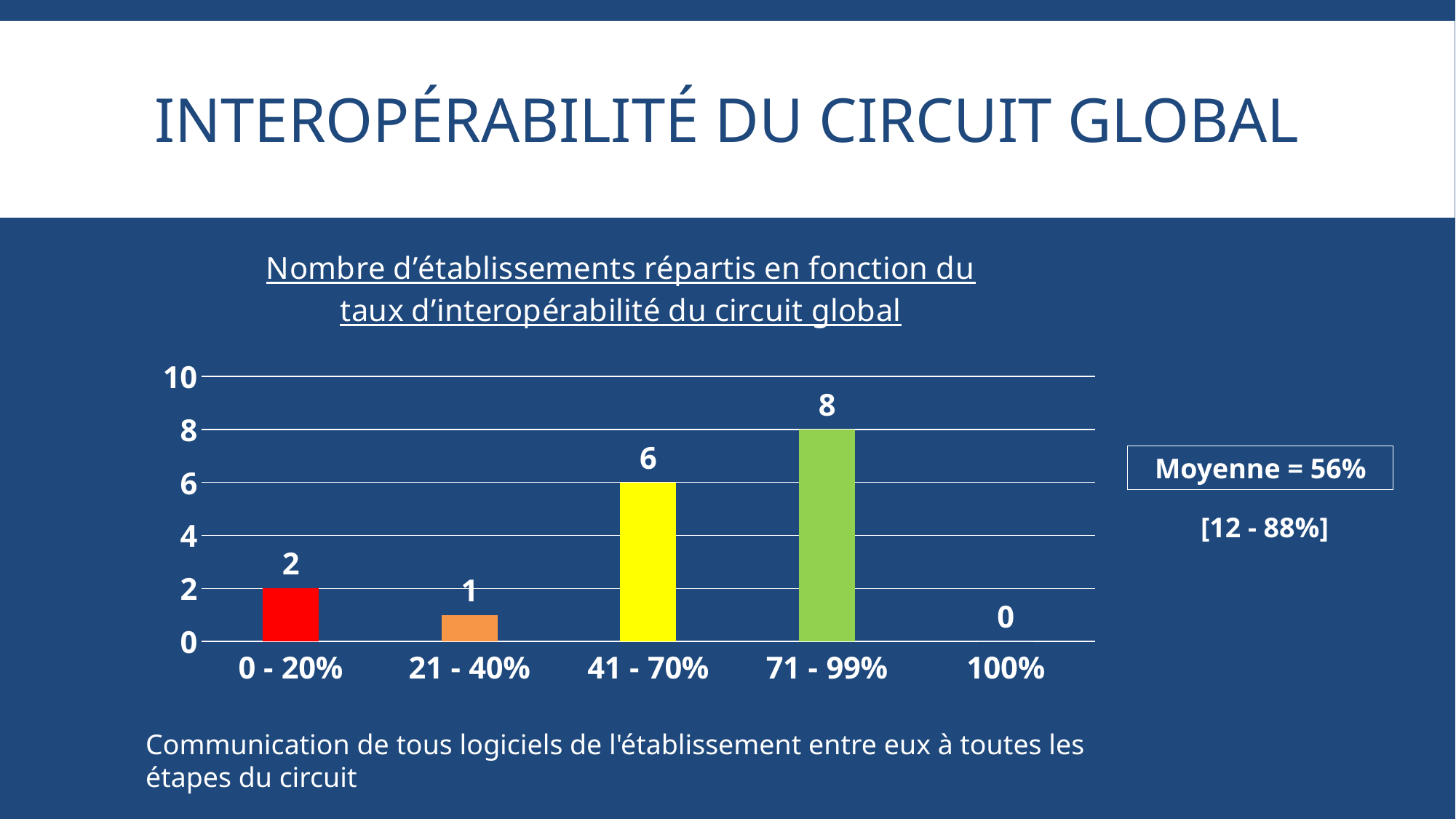
Which is larger, the value for 0 - 20% or the value for 21 - 40%? 0 - 20% Which category has the lowest number of establishments? 100% Which category has the highest number of establishments? 71 - 99% How many establishments are in the 71 - 99% category? 8 What is the average (Moyenne) value stated next to the chart? 56% What kind of chart is shown on the slide? Bar chart What is the difference between the 71 - 99% and 41 - 70% categories? 2 What is the total number of establishments across all categories? 17 What colour is the bar for the 41 - 70% category? Yellow What is the value for the 100% category? 0 How many categories are shown on the x axis? 5 What is the value for the 0 - 20% category? 2